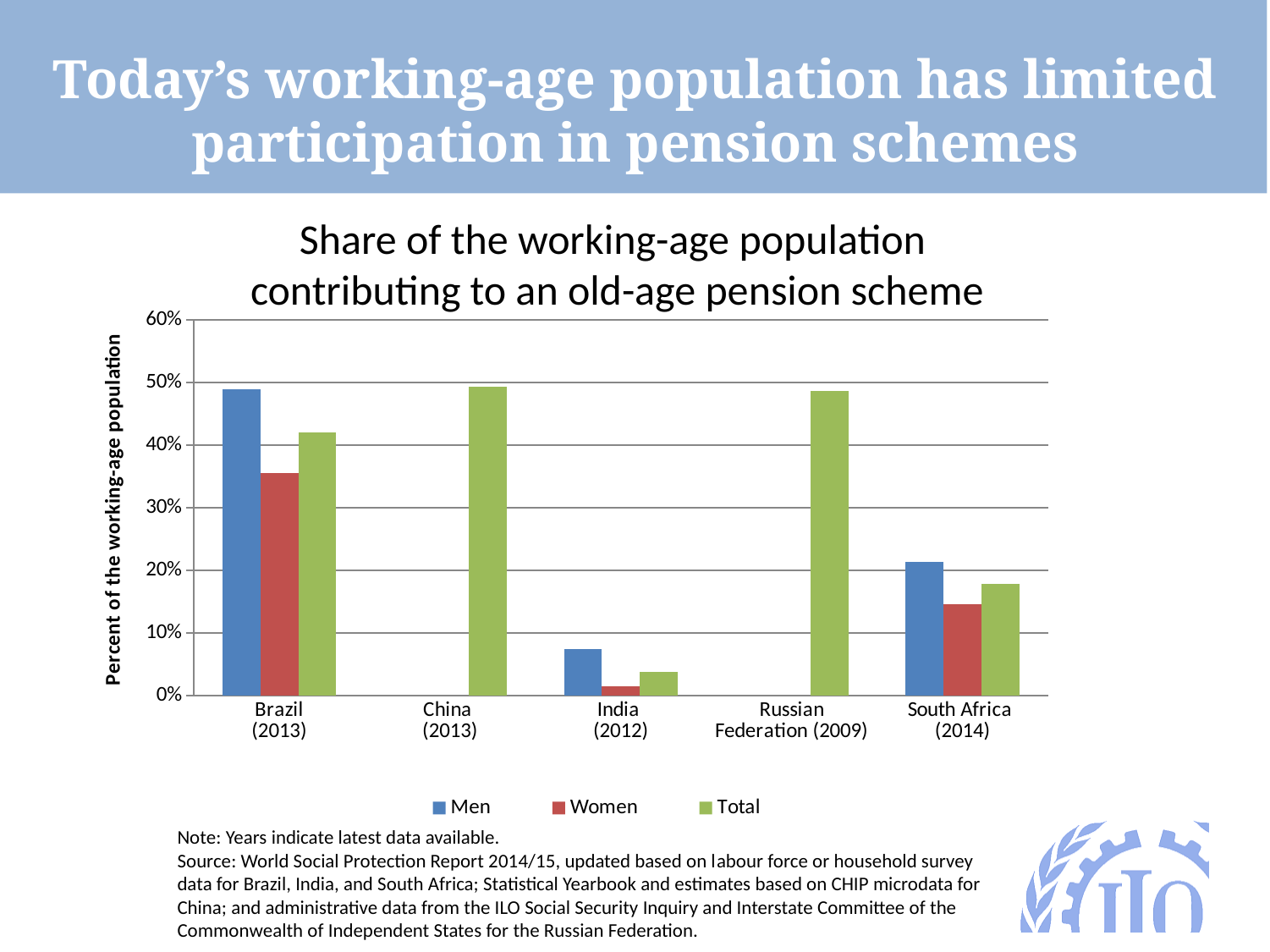
Is the Women value for Brazil (2013) greater or less than 30%? greater How many series does the legend list? 3 Is the Total value for India (2012) greater or less than 10%? less Is the Total value for Russian Federation (2009) greater or less than 40%? greater What kind of chart is shown on the slide? bar chart What is the label on the vertical axis of the chart? Percent of the working-age population Which is larger for Brazil (2013): the Men value or the Women value? Men How many countries are shown on the x axis? 5 Which country has the highest Men value? Brazil (2013) Which country has the larger Total value: South Africa (2014) or India (2012)? South Africa (2014) Which country has the lowest Total value? India (2012)